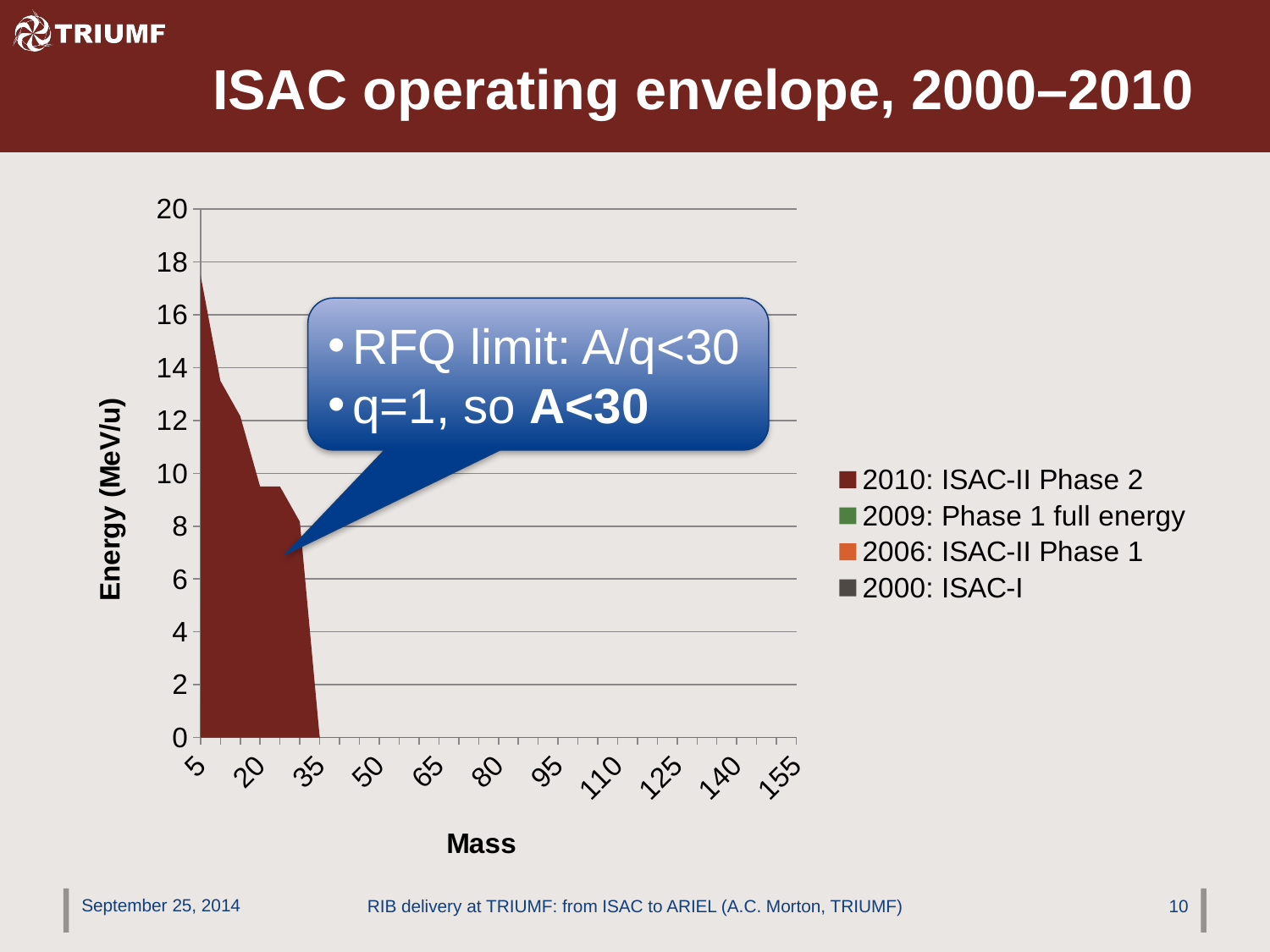
What is the label of the y axis? Energy (MeV/u) Which of the two has the higher energy value: mass 5 or mass 35? Mass 5 Does the plotted energy rise or fall as mass increases along the x axis? Falls What is the highest value shown on the Energy axis? 20 What is the label of the x axis? Mass Is the energy value at mass 20 greater or less than 10? less What kind of chart is shown on the slide? Area chart How many tick labels are shown on the Mass axis? 11 Is the energy value at mass 5 greater or less than 16? greater How many series does the chart legend list? 4